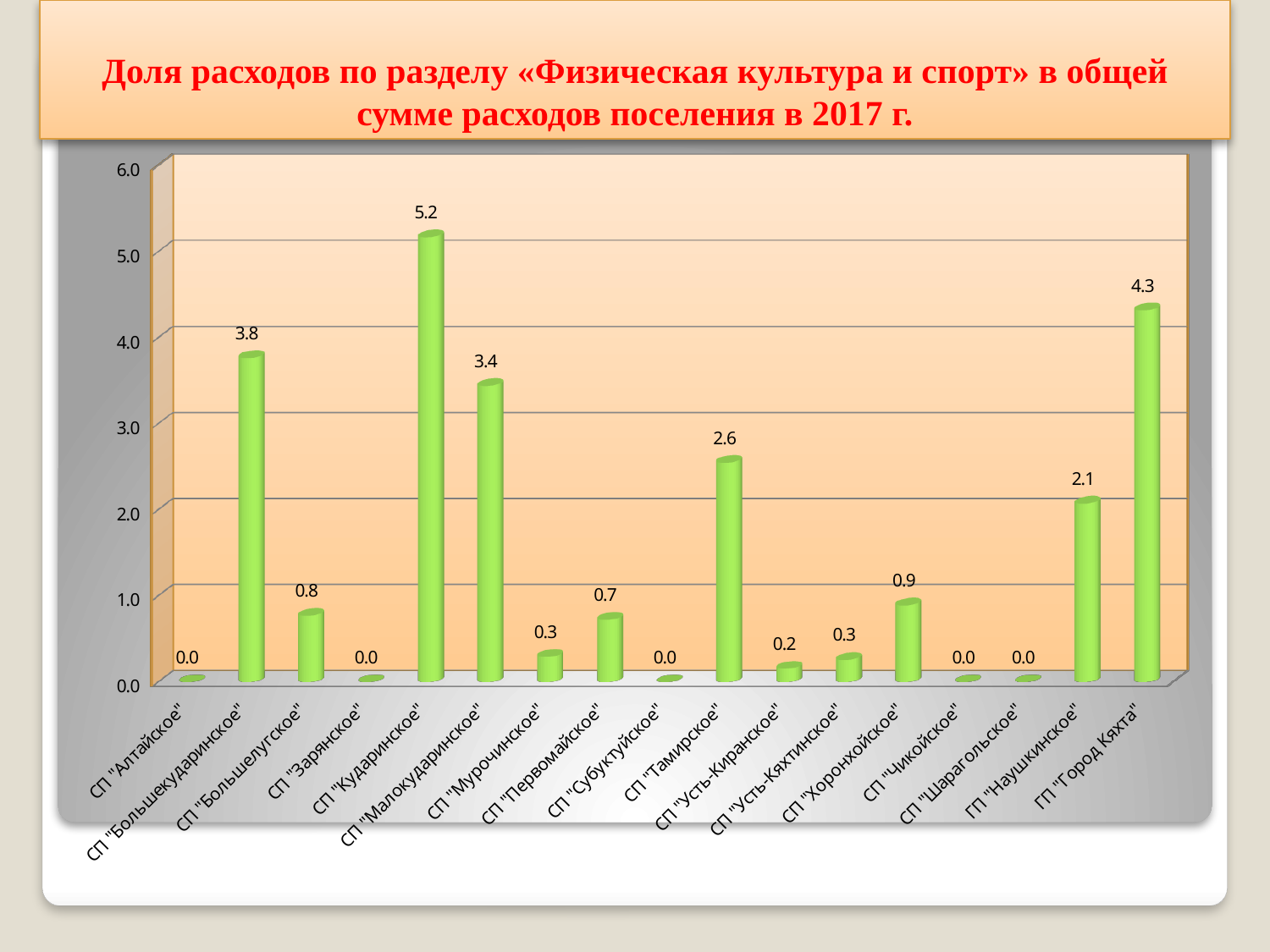
What is the difference between the values for СП "Кударинское" and ГП "Город Кяхта"? 0.9 What is the difference between the values for СП "Большекударинское" and СП "Малокударинское"? 0.4 What is the value for СП "Тамирское"? 2.6 What is the value for СП "Кударинское"? 5.2 What is the value for ГП "Город Кяхта"? 4.3 Is the value for СП "Большекударинское" greater or less than 3.0? greater Which category has the highest value? СП "Кударинское" What is the value for СП "Хоронхойское"? 0.9 What kind of chart is shown on the slide? bar chart Which is larger, the value for СП "Тамирское" or ГП "Наушкинское"? СП "Тамирское" How many categories are shown on the x axis? 17 How many categories have a value of 0.0? 5